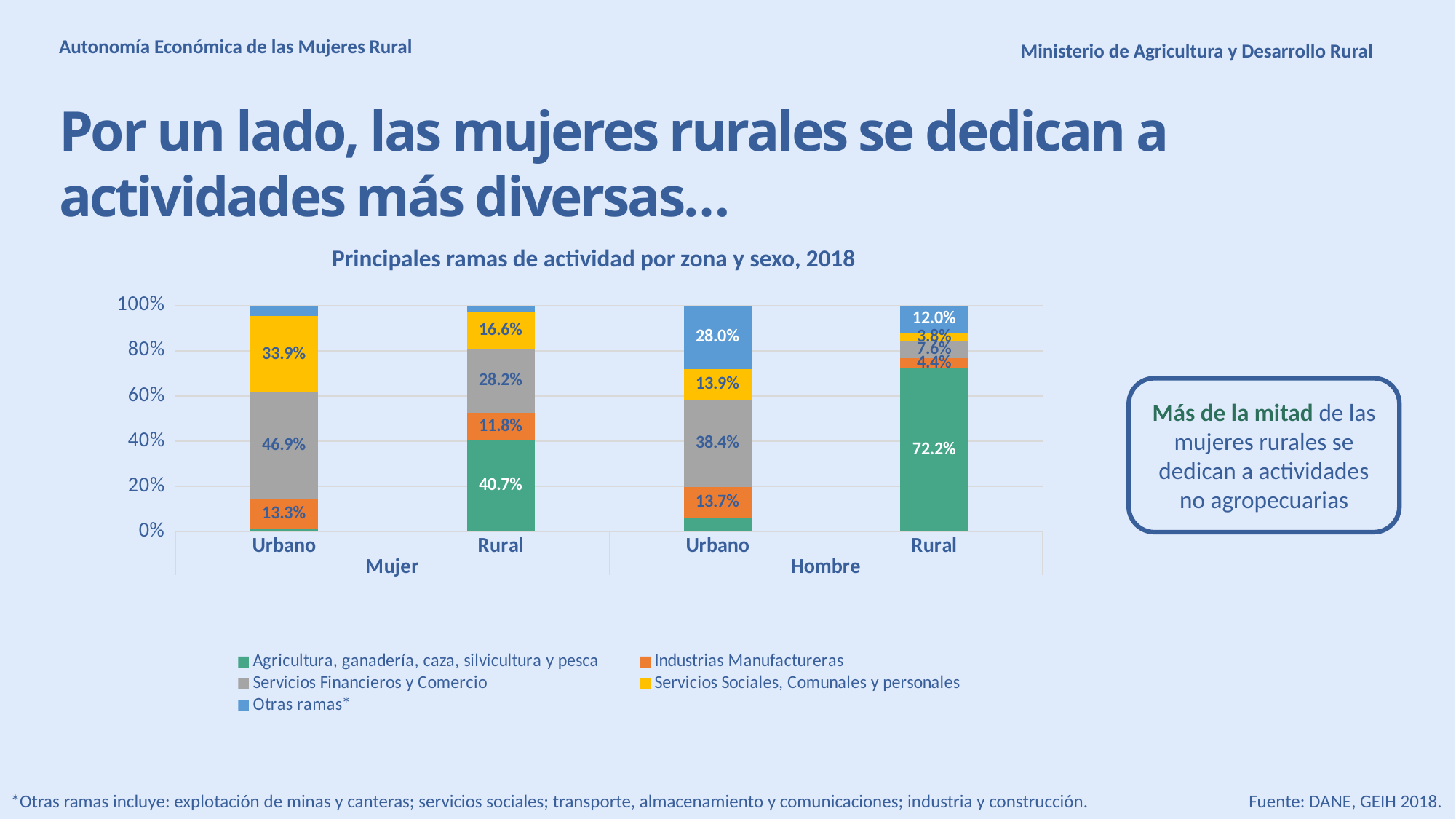
Which group has the highest share in Agricultura, ganadería, caza, silvicultura y pesca? Hombre Rural What share of rural men work in Industrias Manufactureras? 4.4% What is the difference between the Agricultura share of rural men (72.2%) and rural women (40.7%)? 31.5% What kind of chart is shown on the slide? Stacked bar chart What is the title of the chart? Principales ramas de actividad por zona y sexo, 2018 Which group has the lowest share in Servicios Sociales, Comunales y personales? Hombre Rural What share of urban women work in Servicios Financieros y Comercio? 46.9% What is the value for Otras ramas* among urban men (Hombre, Urbano)? 28.0% How many bars (zone-sex groups) are shown in the chart? 4 What share of rural women work in Agricultura, ganadería, caza, silvicultura y pesca? 40.7% Which is larger: the Servicios Financieros y Comercio share for urban women or for urban men? Urban women (46.9%) How many series does the legend list? 5